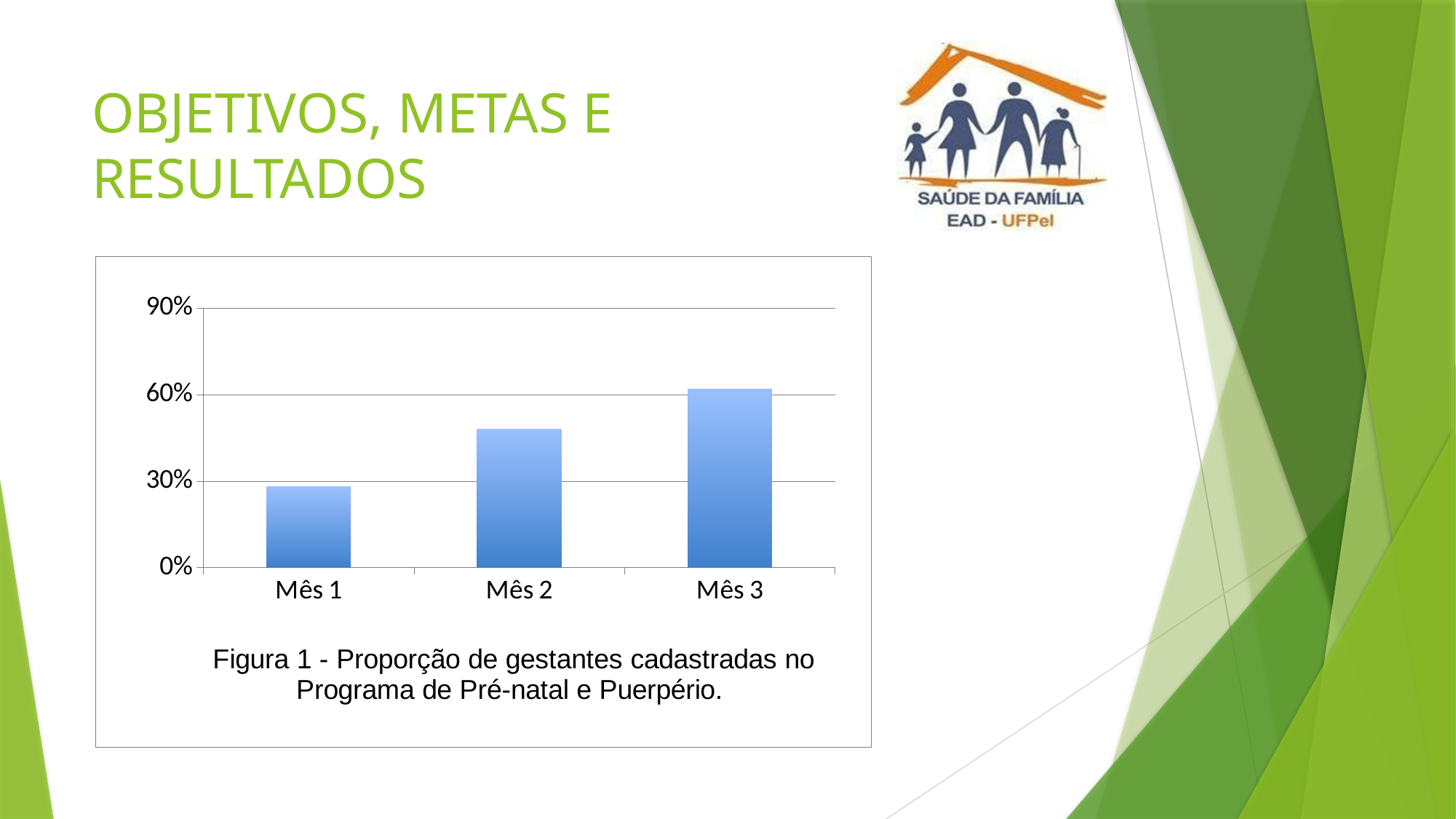
Is the value for Mês 2 greater or less than 60%? less Which month has the lowest proportion in the chart? Mês 1 What is the caption (figure title) given below the chart? Figura 1 - Proporção de gestantes cadastradas no Programa de Pré-natal e Puerpério. How many months (categories) are plotted in the chart? 3 What kind of chart is shown on the slide? Bar chart Do the values rise or fall from Mês 1 to Mês 3? Rise Is the value for Mês 3 greater or less than 90%? less Which is larger, the value for Mês 3 or the value for Mês 2? Mês 3 Which month has the highest proportion in the chart? Mês 3 Is the value for Mês 1 greater or less than 60%? less Which is larger, the value for Mês 2 or the value for Mês 1? Mês 2